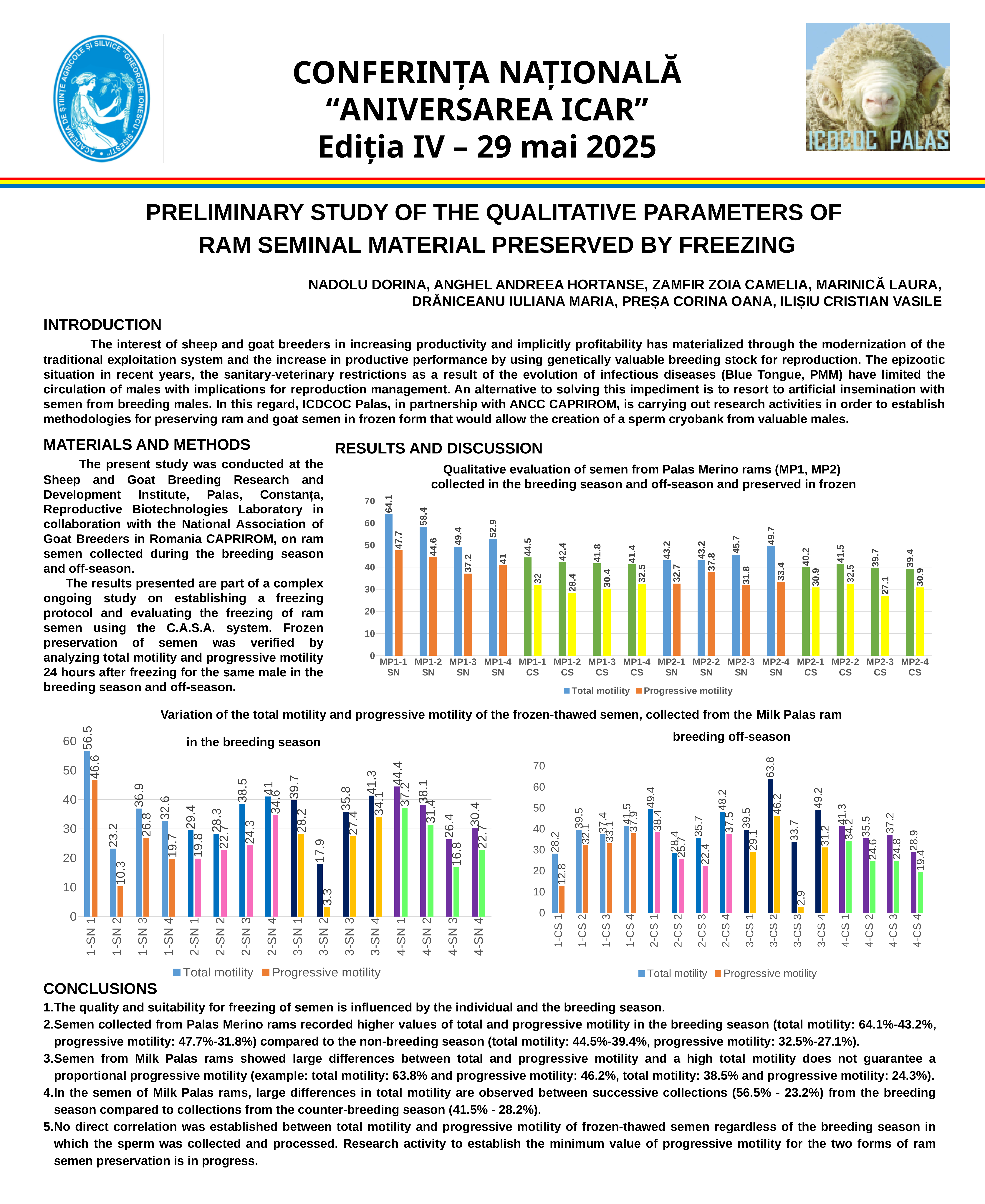
In the chart titled 'Qualitative evaluation of semen from Palas Merino rams', what is the progressive motility for MP2-3 CS? 27.1 In the 'in the breeding season' chart (bottom left), which is larger: the total motility for 1-SN 1 or for 4-SN 1? 1-SN 1 In the 'breeding off-season' chart (bottom right), what is the difference between total motility and progressive motility for 2-CS 1? 11 In the 'in the breeding season' chart (bottom left), which category has the lowest total motility? 3-SN 2 In the chart titled 'Qualitative evaluation of semen from Palas Merino rams', how many categories are shown on the x axis? 16 In the 'breeding off-season' chart (bottom right), which category has the lowest progressive motility? 3-CS 3 In the chart titled 'Qualitative evaluation of semen from Palas Merino rams', what is the total motility for MP1-1 SN? 64.1 In the 'in the breeding season' chart (bottom left), what is the progressive motility for 3-SN 2? 3.3 In the chart titled 'Qualitative evaluation of semen from Palas Merino rams', what is the difference between total motility and progressive motility for MP1-2 SN? 13.8 How many series does the legend of the 'breeding off-season' chart (bottom right) list? 2 In the chart titled 'Qualitative evaluation of semen from Palas Merino rams', which category has the highest total motility? MP1-1 SN In the 'breeding off-season' chart (bottom right), what is the total motility for 3-CS 2? 63.8